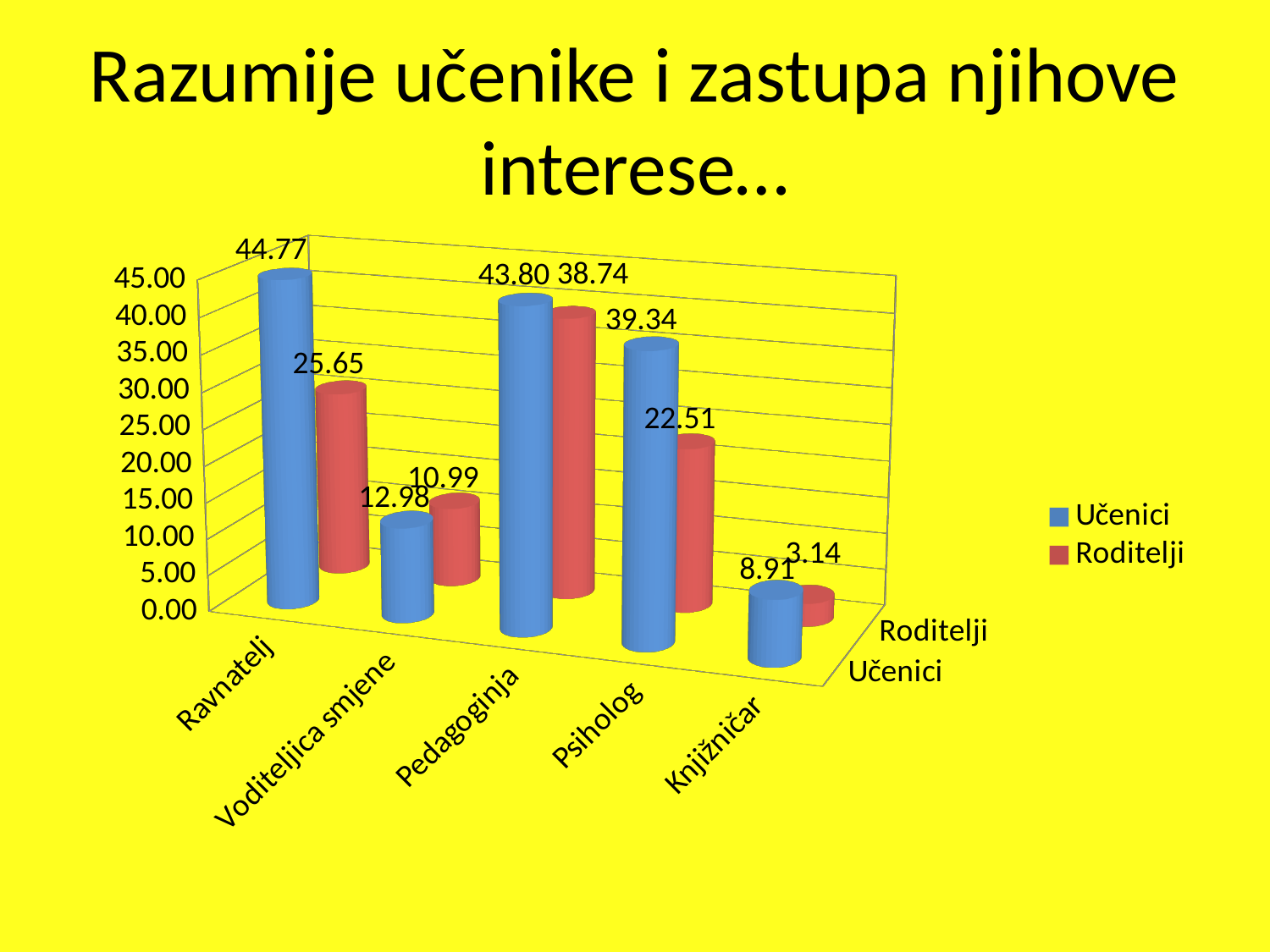
How many series does the legend list? 2 What is the difference between the Učenici and Roditelji values for Ravnatelj? 19.12 What is the Učenici value for Psiholog? 39.34 How many categories are shown on the x axis? 5 Which category has the highest Učenici value? Ravnatelj What is the Roditelji value for Pedagoginja? 38.74 What kind of chart is shown on the slide? Bar chart Which category has the lowest Roditelji value? Knjižničar Which colour represents the Roditelji series? Red What is the Roditelji value for Knjižničar? 3.14 Which is larger for Psiholog, the Učenici value or the Roditelji value? Učenici What is the Učenici value for Ravnatelj? 44.77